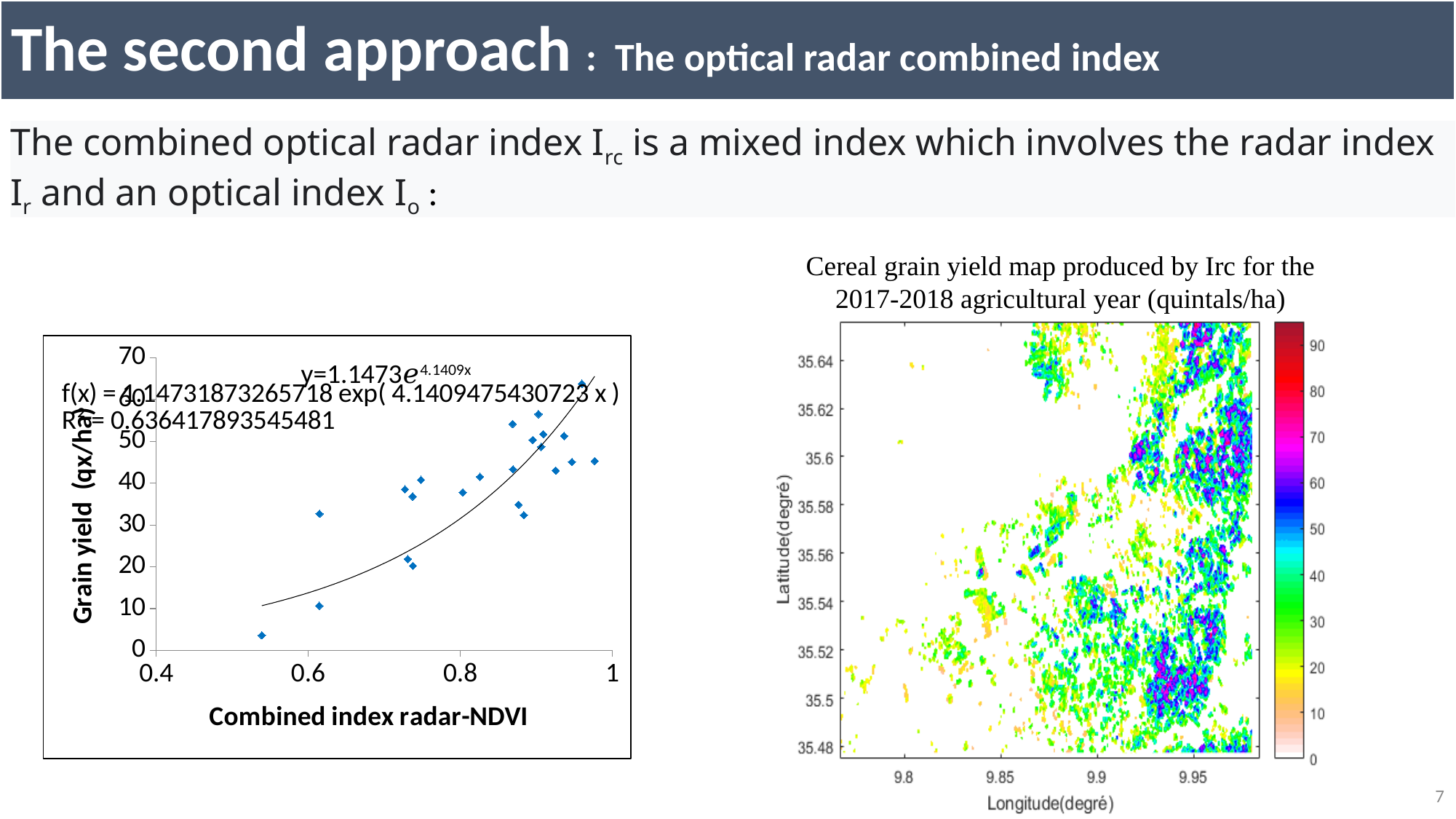
In the scatter chart, what is the label of the x axis? Combined index radar-NDVI In the scatter chart, is the grain yield of the point at a combined index of about 0.96 greater or less than 40? greater In the scatter chart, is the highest grain yield plotted greater or less than 50? greater In the scatter chart, what R² value is printed for the fitted trendline? 0.636417893545481 In the scatter chart, do grain yield values generally rise or fall as the combined index radar-NDVI increases? rise In the scatter chart, is the lowest grain yield plotted greater or less than 10? less In the scatter chart, which has the higher grain yield: the point at a combined index of about 0.54 or the point at about 0.96? the point at about 0.96 In the scatter chart, what is the trendline equation shown in the short form above the curve? y=1.1473e^4.1409x What kind of chart is shown on the left of the slide? scatter chart In the scatter chart, what is the maximum value shown on the y axis? 70 In the scatter chart, what is the label of the y axis? Grain yield (qx/ha)